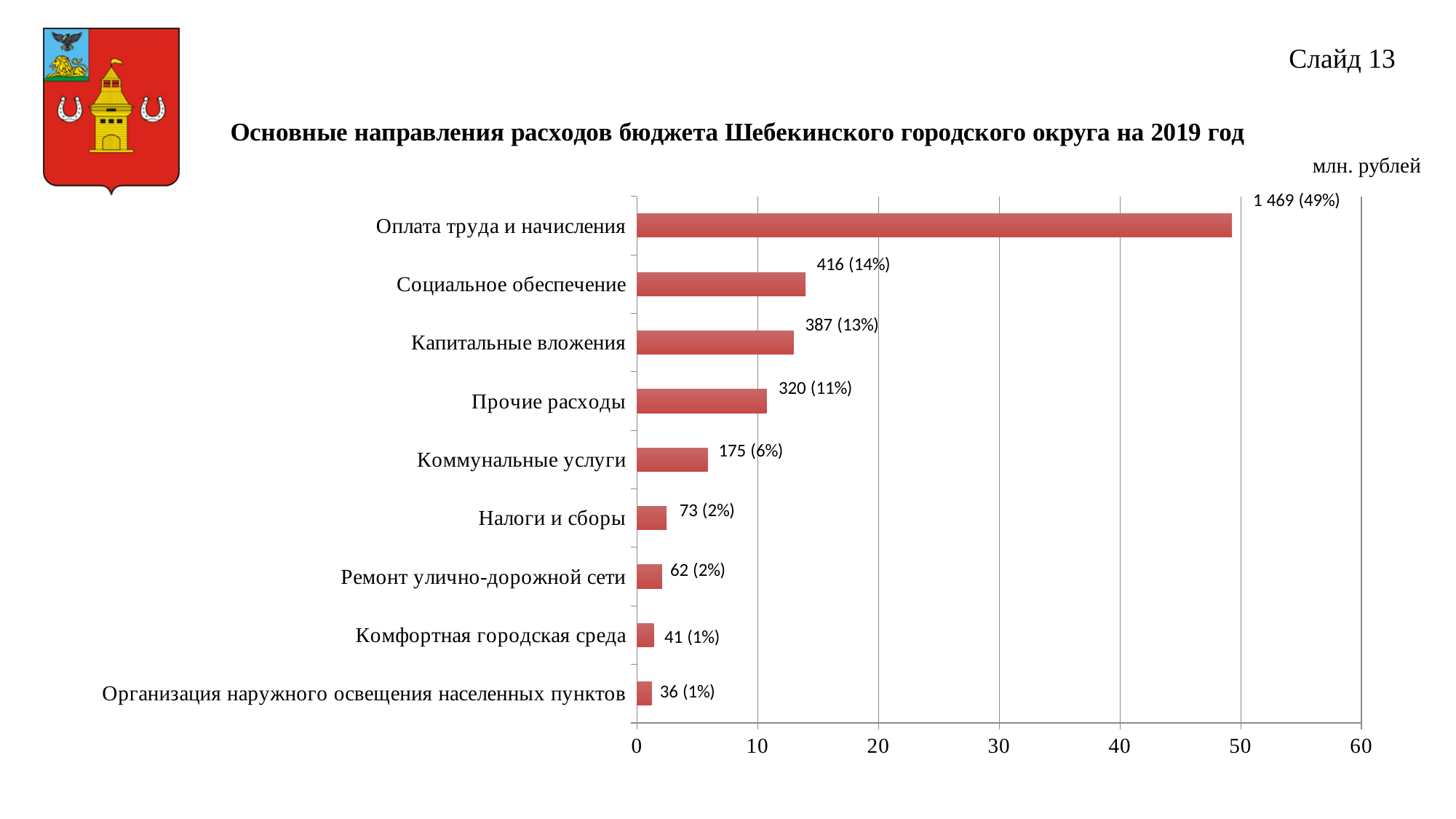
How many categories are shown in the chart? 9 What is the data label for Организация наружного освещения населенных пунктов? 36 (1%) Which category has the highest value? Оплата труда и начисления What is the data label for Коммунальные услуги? 175 (6%) What is the data label for Оплата труда и начисления? 1 469 (49%) What is the difference in million rubles between Социальное обеспечение (416) and Капитальные вложения (387)? 29 What is the data label for Социальное обеспечение? 416 (14%) Is the bar for Оплата труда и начисления greater or less than 50 on the axis? less What kind of chart is shown on the slide? bar chart Which category has the lowest value? Организация наружного освещения населенных пунктов What unit is indicated above the chart? млн. рублей Which is larger, Прочие расходы or Коммунальные услуги? Прочие расходы